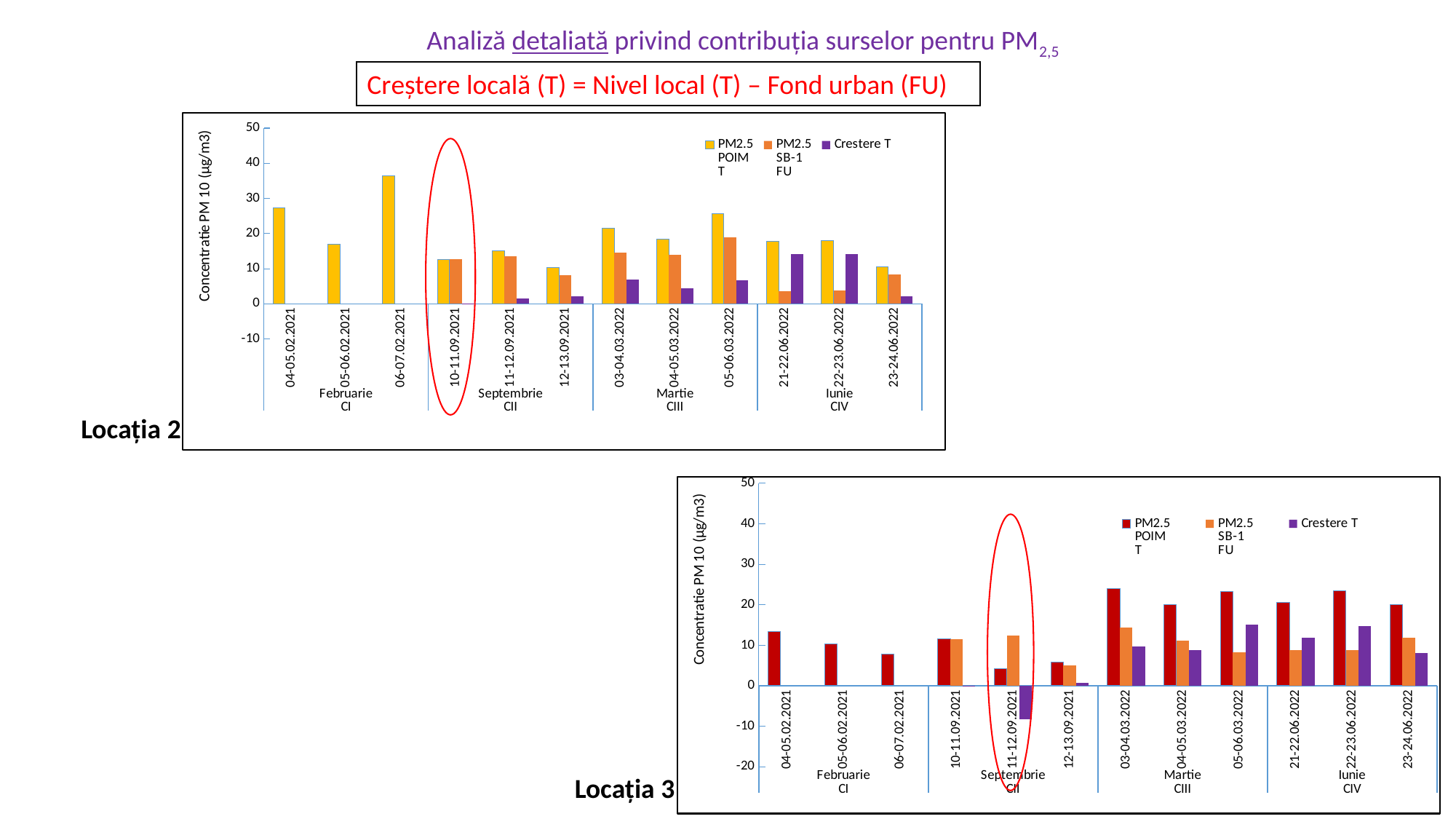
In the Locația 2 chart, which date has the highest PM2.5 POIM T value? 06-07.02.2021 What is the y-axis title of the Locația 3 chart? Concentratie PM 10 (µg/m3) In the Locația 3 chart, for 11-12.09.2021, which is larger: PM2.5 POIM T or PM2.5 SB-1 FU? PM2.5 SB-1 FU How many series does the legend of the Locația 3 chart list? 3 In the Locația 2 chart, is the Crestere T value for 21-22.06.2022 greater or less than 10? greater How many date categories are plotted on the x axis of the Locația 2 chart? 12 In the Locația 2 chart, for 21-22.06.2022, which is larger: PM2.5 SB-1 FU or Crestere T? Crestere T In the Locația 3 chart, which date has the lowest PM2.5 POIM T value? 11-12.09.2021 What type of chart is shown for Locația 2? bar chart In the Locația 2 chart, is the PM2.5 POIM T value for 06-07.02.2021 greater or less than 30? greater In the Locația 3 chart, is the Crestere T value for 11-12.09.2021 greater or less than 0? less